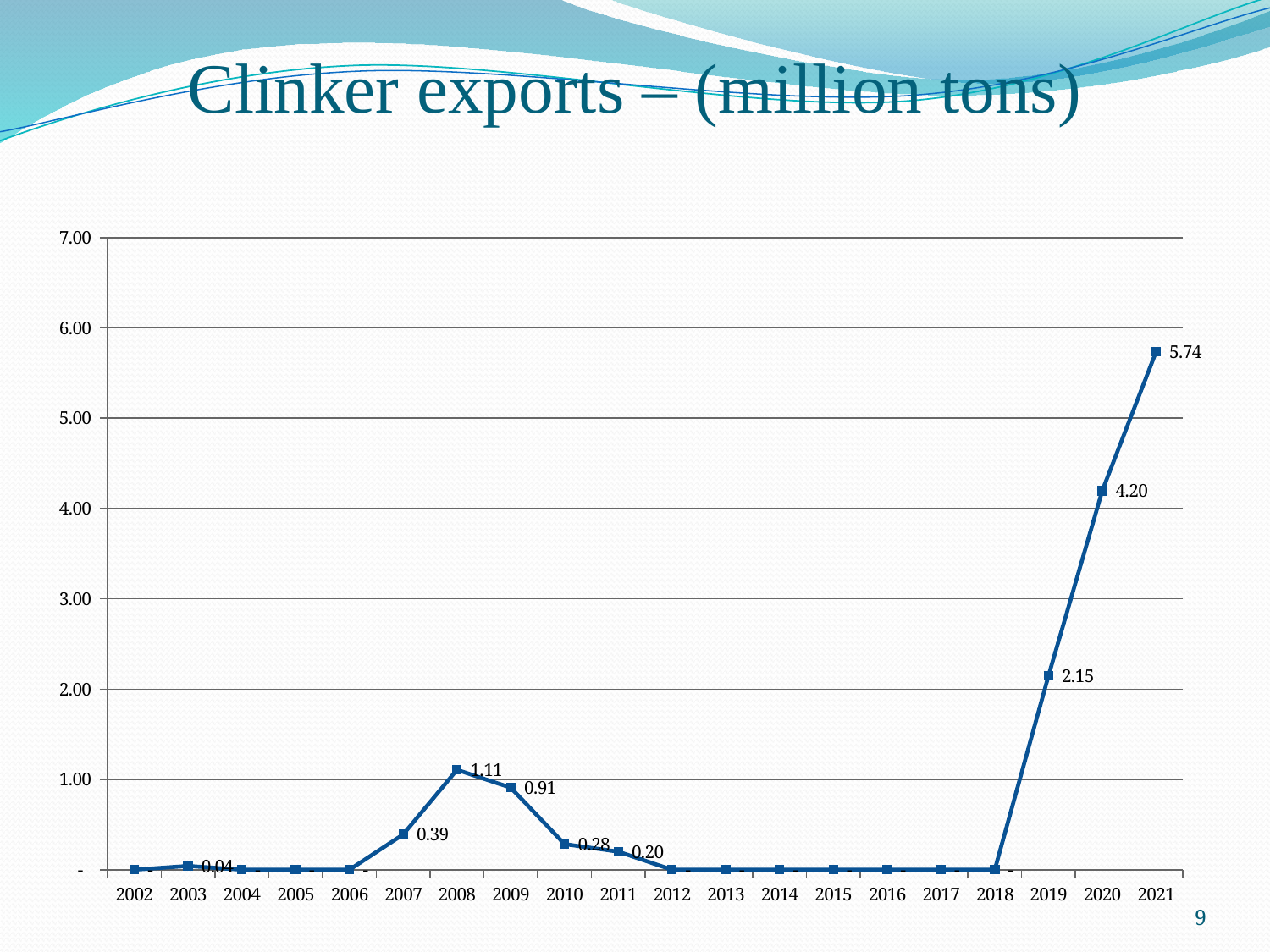
What is the difference in clinker exports between 2021 and 2020? 1.54 Which year has the highest clinker exports? 2021 Which year has higher clinker exports, 2010 or 2011? 2010 What is the value of clinker exports in 2008? 1.11 Do clinker exports rise or fall from 2019 to 2021? Rise Is the value for 2020 greater or less than 4.00? greater How many years are shown on the x axis of the chart? 20 What is the difference in clinker exports between 2008 and 2009? 0.20 What is the value of clinker exports in 2019? 2.15 What is the value of clinker exports in 2021? 5.74 What kind of chart is shown on the slide? Line chart What is the value of clinker exports in 2007? 0.39